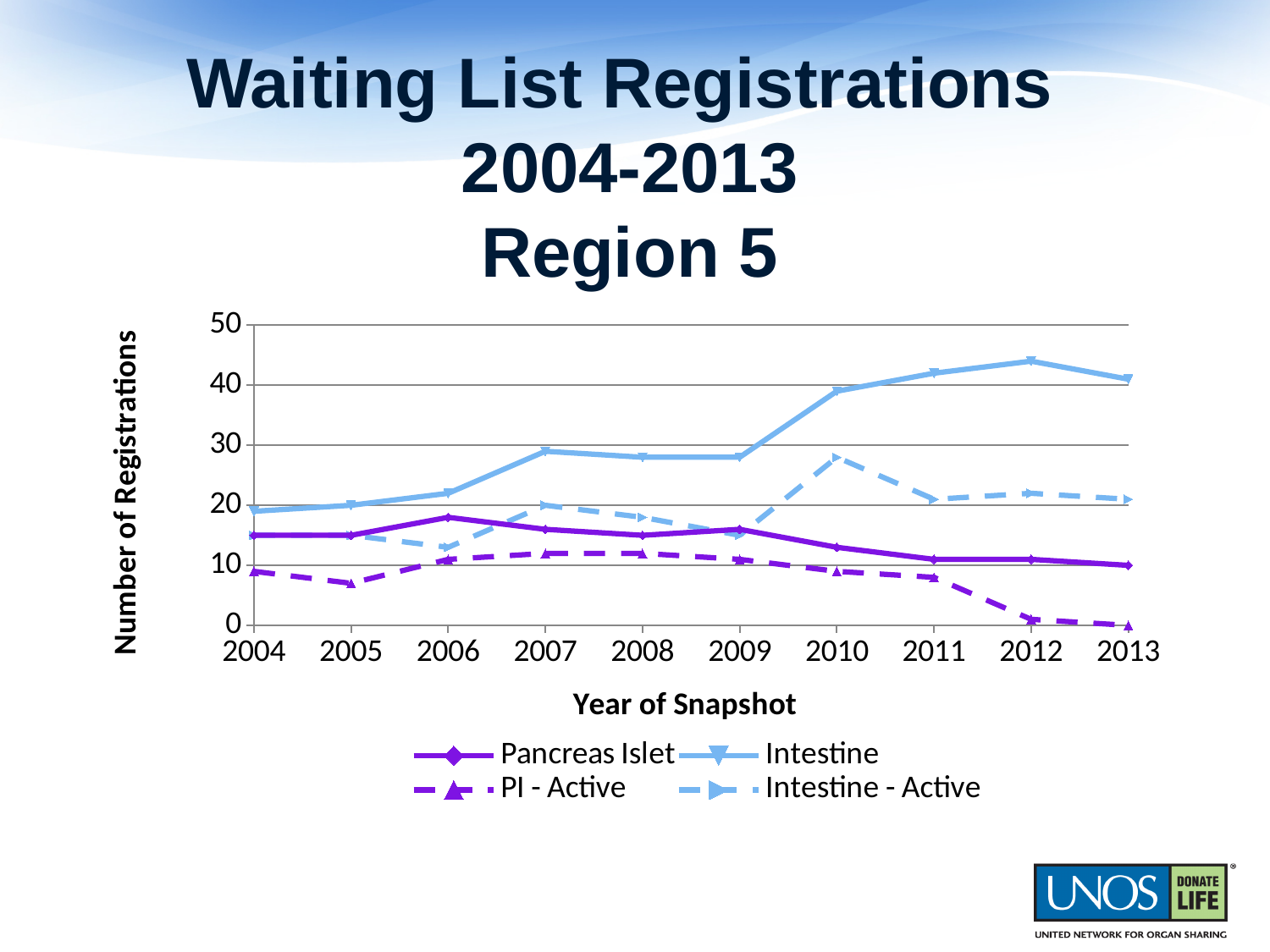
In 2011, which series has the larger value: Intestine or Pancreas Islet? Intestine In which year does the Intestine series reach its highest value? 2012 How many series does the legend list? 4 Does the Pancreas Islet series generally rise or fall from 2009 to 2013? fall Is the value for Intestine in 2012 greater or less than 40? greater In which year does the PI - Active series reach its lowest value? 2013 What is the label of the y axis? Number of Registrations What kind of chart is shown on the slide? line chart Is the value for Pancreas Islet in 2006 greater or less than 20? less Is the value for PI - Active in 2005 greater or less than 10? less How many years are shown along the x axis? 10